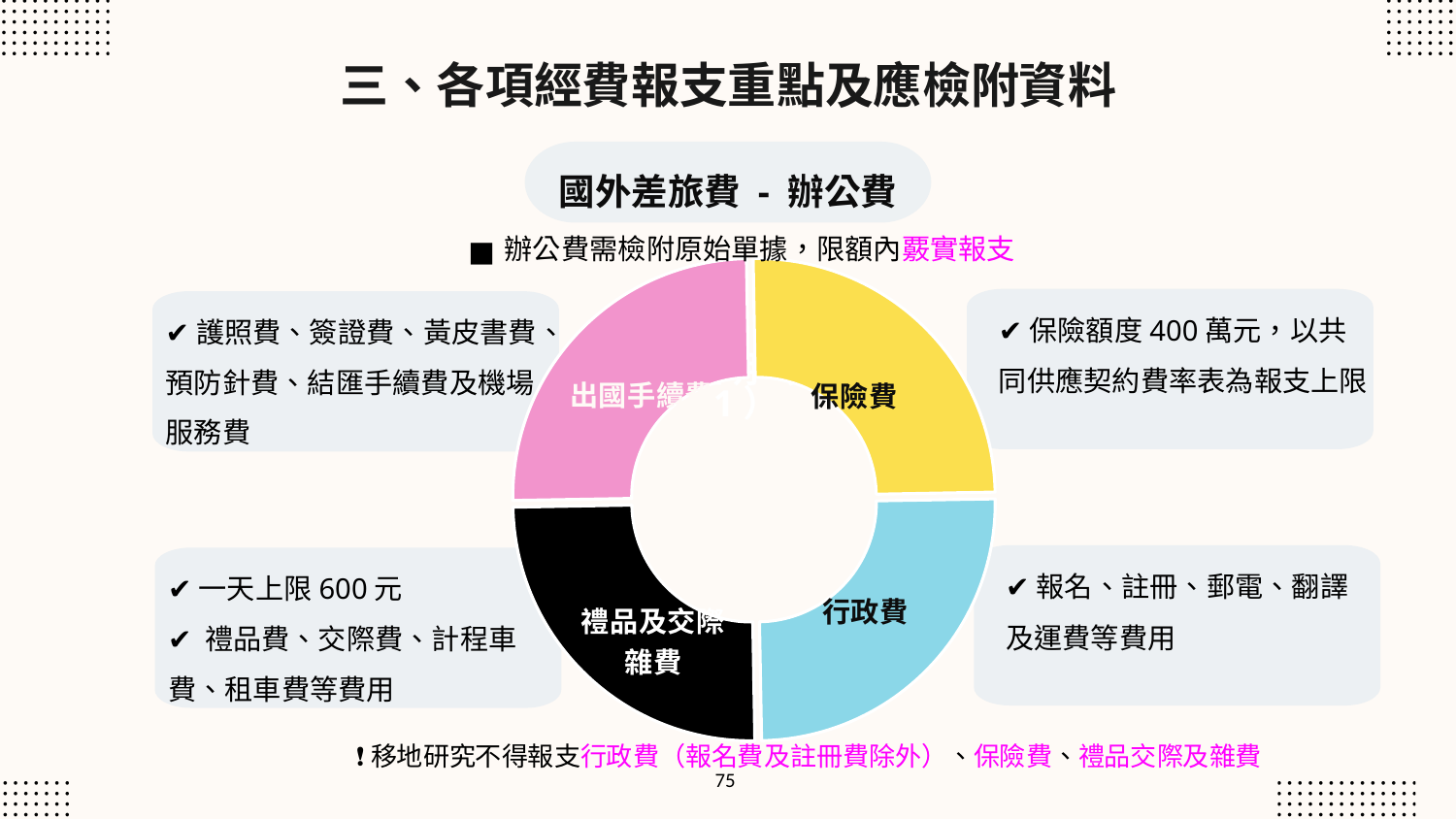
What heading appears directly above the donut chart? 國外差旅費 - 辦公費 How many segments does the donut chart have? 4 Which segment of the donut chart is coloured yellow? 保險費 Which segment of the donut chart is located in the lower-right position? 行政費 What kind of chart is shown on the slide? Donut (pie) chart Which segment of the donut chart is located in the upper-left position? 出國手續費 Which segment of the donut chart is coloured black? 禮品及交際雜費 What is the label of the light blue segment in the donut chart? 行政費 What is the label of the pink segment in the donut chart? 出國手續費